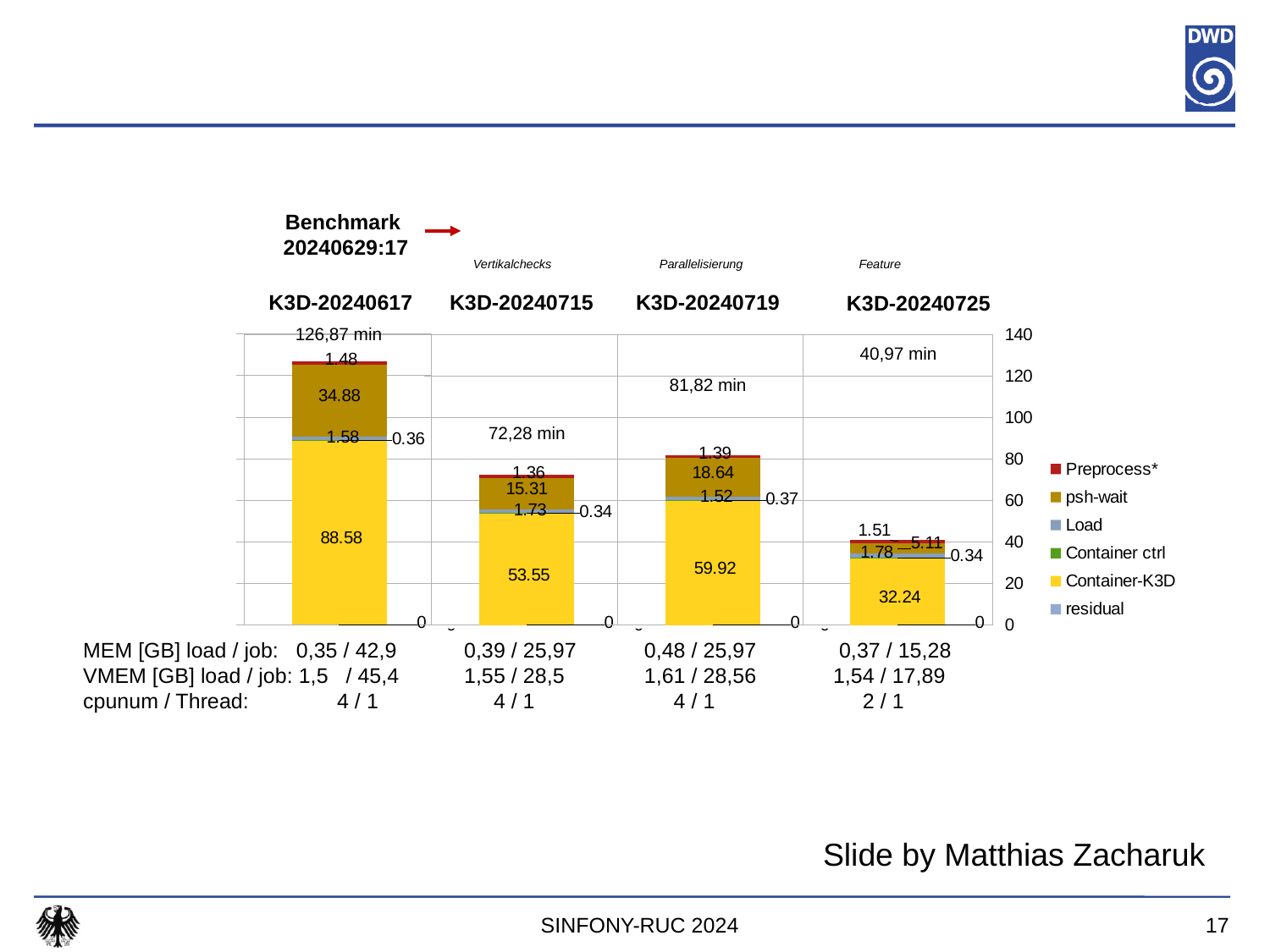
What is the total time annotated for the K3D-20240725 bar? 40,97 min What is the Preprocess* value for K3D-20240725? 1.51 Is the total bar height for K3D-20240617 greater or less than 120? greater How many series does the legend list? 6 What is the difference between the Container-K3D values of K3D-20240719 and K3D-20240715? 6.37 What kind of chart is shown on the slide? stacked bar chart What is the Container-K3D value for K3D-20240617? 88.58 Which K3D version has the lowest total bar? K3D-20240725 How many bars (K3D versions) are plotted in the chart? 4 Which has the larger psh-wait value, K3D-20240715 or K3D-20240719? K3D-20240719 What is the psh-wait value for K3D-20240719? 18.64 Which K3D version has the highest Container-K3D value? K3D-20240617